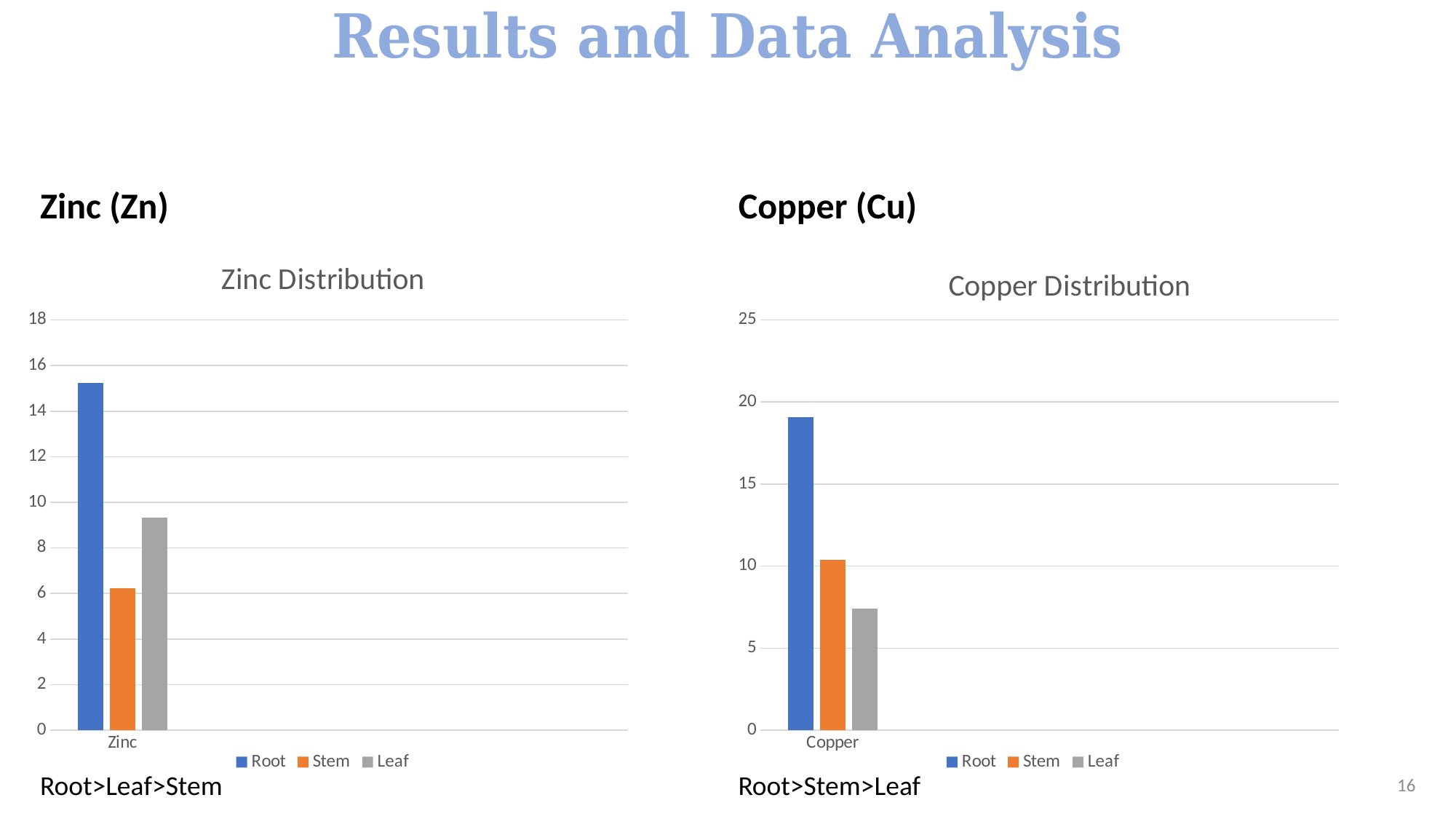
In the Copper Distribution chart, is the value for Leaf greater or less than 10? less In the Copper Distribution chart, which series has the highest value? Root In the Zinc Distribution chart, is the value for Root greater or less than 14? greater In the Zinc Distribution chart, which series has the highest value? Root In the Zinc Distribution chart, which is larger, Leaf or Stem? Leaf In the Copper Distribution chart, which series has the lowest value? Leaf In the Zinc Distribution chart, how many series does the legend list? 3 In the Copper Distribution chart, is the value for Root greater or less than 15? greater In the Zinc Distribution chart, which series has the lowest value? Stem What is the title of the chart on the right side of the slide? Copper Distribution In the Zinc Distribution chart, what kind of chart is shown? bar chart